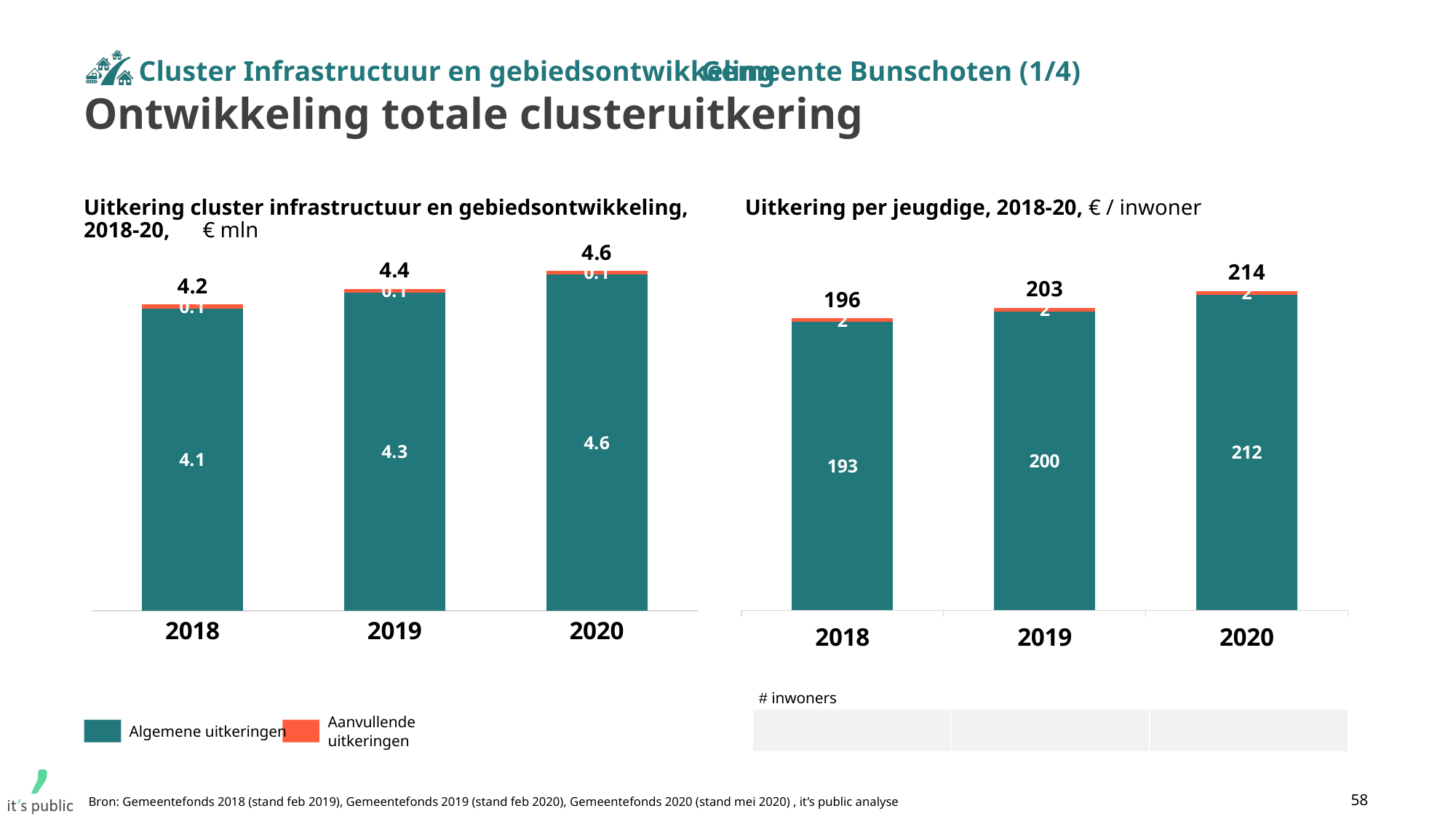
In the left chart (Uitkering cluster infrastructuur en gebiedsontwikkeling), what is the value of Aanvullende uitkeringen for 2018? 0.1 In the right chart (Uitkering per jeugdige), which year has the lowest total? 2018 In the right chart (Uitkering per jeugdige), what is the difference between the total for 2020 and the total for 2018? 18 What kind of chart is the right chart (Uitkering per jeugdige)? stacked bar chart In the left chart (Uitkering cluster infrastructuur en gebiedsontwikkeling), which year has the highest total? 2020 In the left chart (Uitkering cluster infrastructuur en gebiedsontwikkeling), what is the value of Algemene uitkeringen for 2019? 4.3 In the left chart (Uitkering cluster infrastructuur en gebiedsontwikkeling), do the totals rise or fall from 2018 to 2020? rise In the left chart (Uitkering cluster infrastructuur en gebiedsontwikkeling), what is the difference between the total for 2020 and the total for 2018? 0.4 How many series does the legend list for the left chart? 2 In the right chart (Uitkering per jeugdige), what is the value of Algemene uitkeringen for 2020? 212 In the right chart (Uitkering per jeugdige), what is the total of the stacked bar for 2018? 196 In the left chart (Uitkering cluster infrastructuur en gebiedsontwikkeling), what is the total of the stacked bar for 2020? 4.6